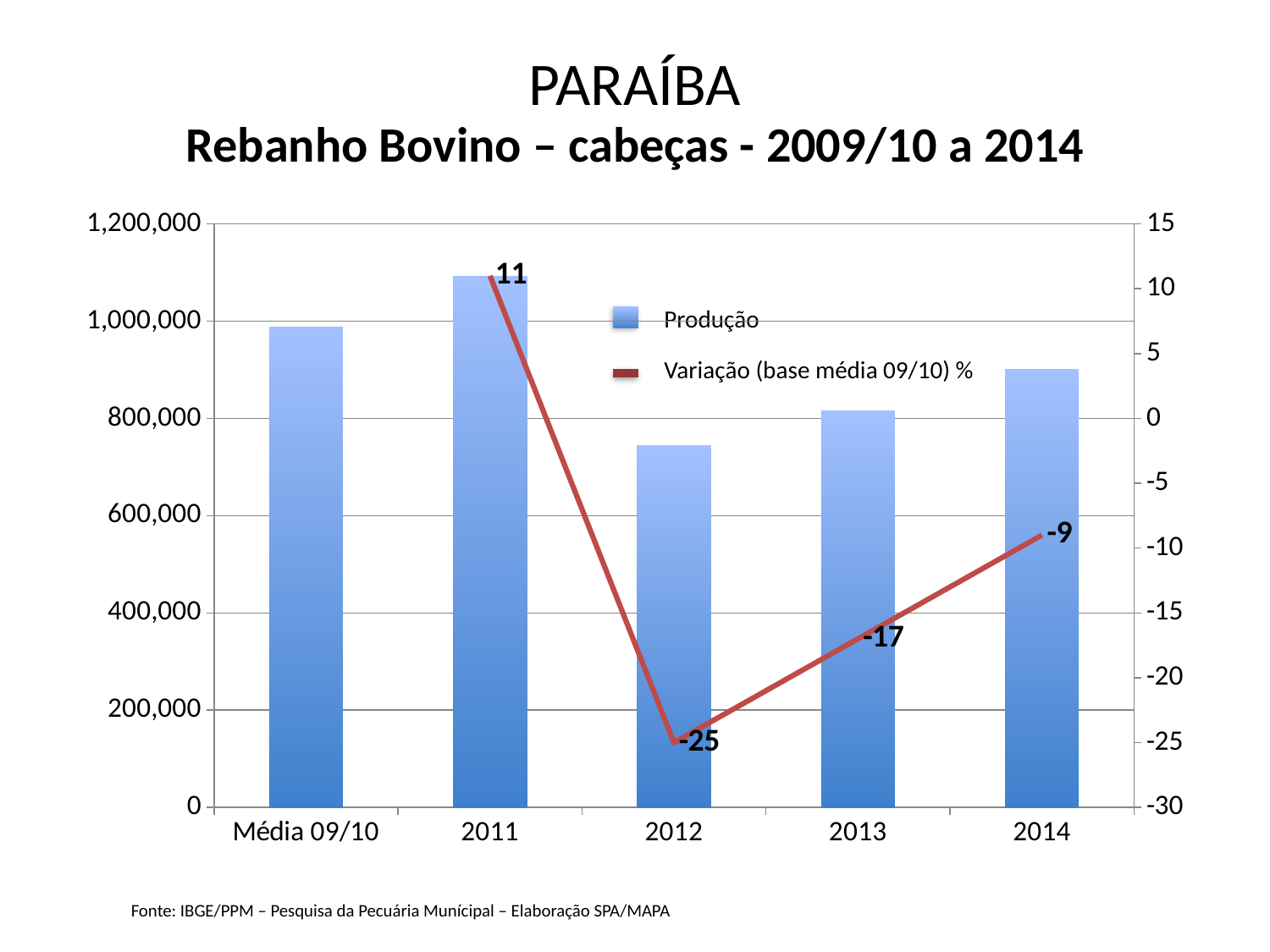
Is the Produção value for 2011 greater or less than 1,000,000? greater How many categories are shown on the x axis? 5 Which category has the highest Produção bar? 2011 What is the value of Variação (base média 09/10) % for 2012? -25 Is the Produção value for 2012 greater or less than 800,000? less Which category has the lowest Produção bar? 2012 What is the value of Variação (base média 09/10) % for 2011? 11 Does the Variação line rise or fall from 2012 to 2014? rise Which is larger, the Produção bar for 2013 or for 2014? 2014 What is the value of Variação (base média 09/10) % for 2014? -9 How many series does the legend list? 2 What is the difference between the Variação values for 2011 and 2012? 36